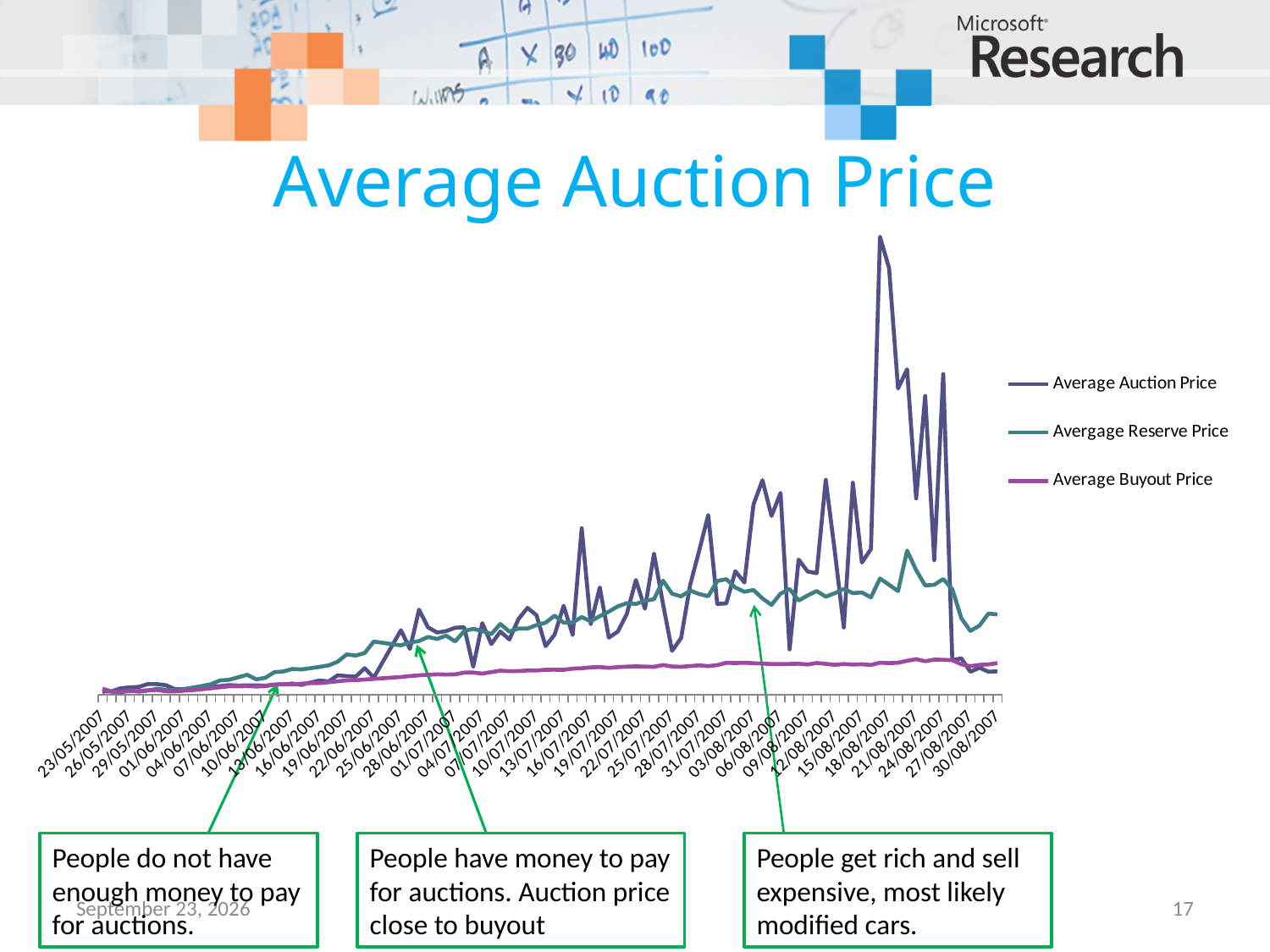
What is the title of the chart? Average Auction Price Which series is drawn in the magenta/purple line at the bottom of the chart? Average Buyout Price Around 18/08/2007, which is larger: the Average Auction Price or the Avergage Reserve Price? Average Auction Price Around 18/08/2007, which is larger: the Average Auction Price or the Average Buyout Price? Average Auction Price How many series does the legend list? 3 Does the Average Auction Price rise or fall between 18/08/2007 and 30/08/2007? fall Which series reaches the highest peak on the chart? Average Auction Price Does the Average Buyout Price generally rise or fall from 23/05/2007 to 24/08/2007? rise At 30/08/2007, which is larger: the Avergage Reserve Price or the Average Auction Price? Avergage Reserve Price Does the Avergage Reserve Price generally rise or fall from 23/05/2007 to 21/08/2007? rise What kind of chart is shown on the slide? line chart